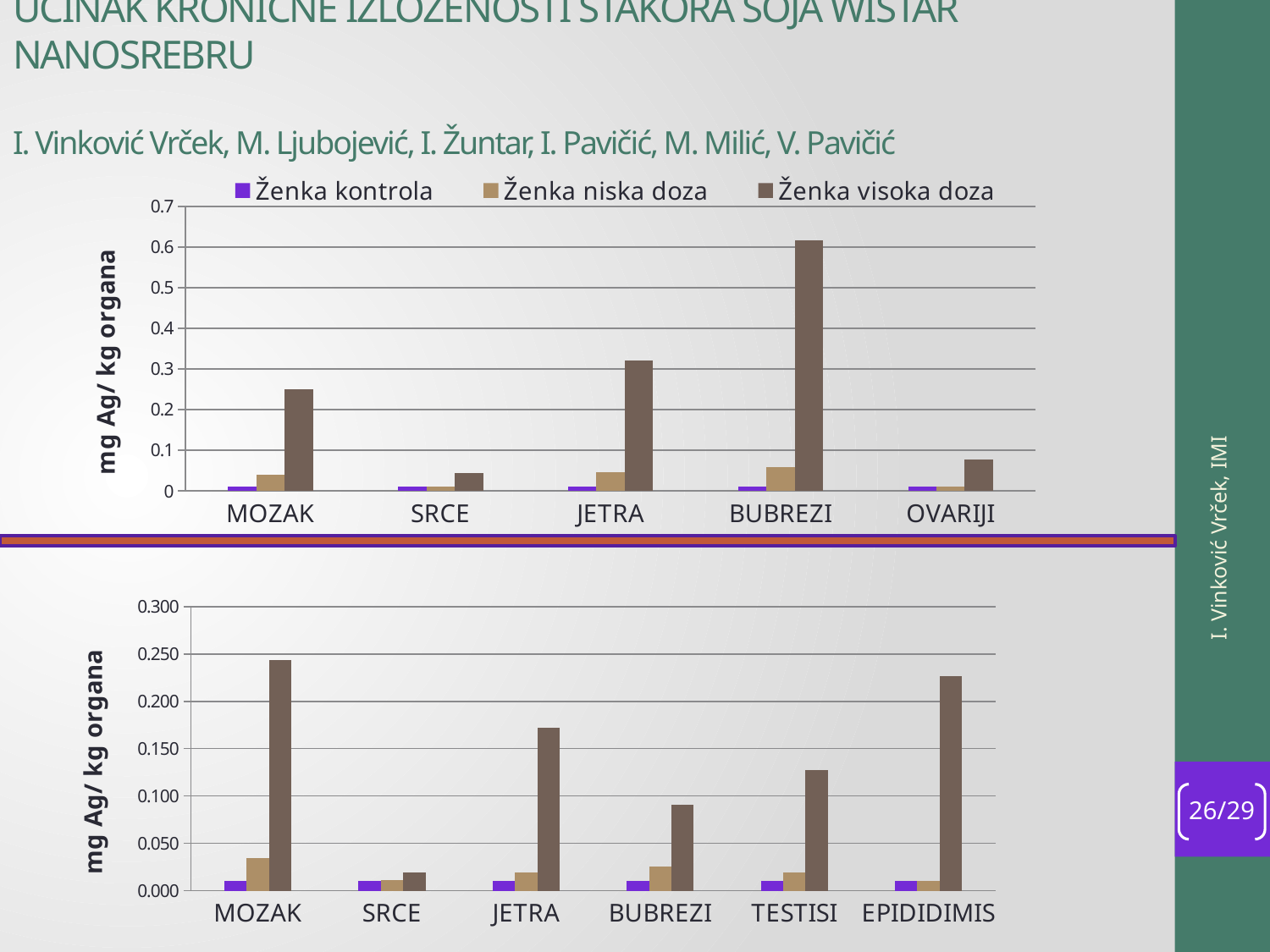
How many series does the legend of the top chart list? 3 In the top chart, is the value for Ženka visoka doza at MOZAK greater or less than 0.2? greater In the top chart, which category has the highest value for Ženka visoka doza? BUBREZI In the top chart, is the value for Ženka visoka doza at BUBREZI greater or less than 0.5? greater In the bottom chart, which category has the tallest dark brown bar? MOZAK How many categories are shown on the x axis of the bottom chart? 6 What type of chart is the bottom chart? bar chart In the top chart, is the value for Ženka visoka doza at JETRA greater or less than 0.4? less In the top chart, which is larger for Ženka visoka doza: JETRA or OVARIJI? JETRA How many categories are shown on the x axis of the top chart? 5 In the top chart, which category has the lowest value for Ženka visoka doza? SRCE